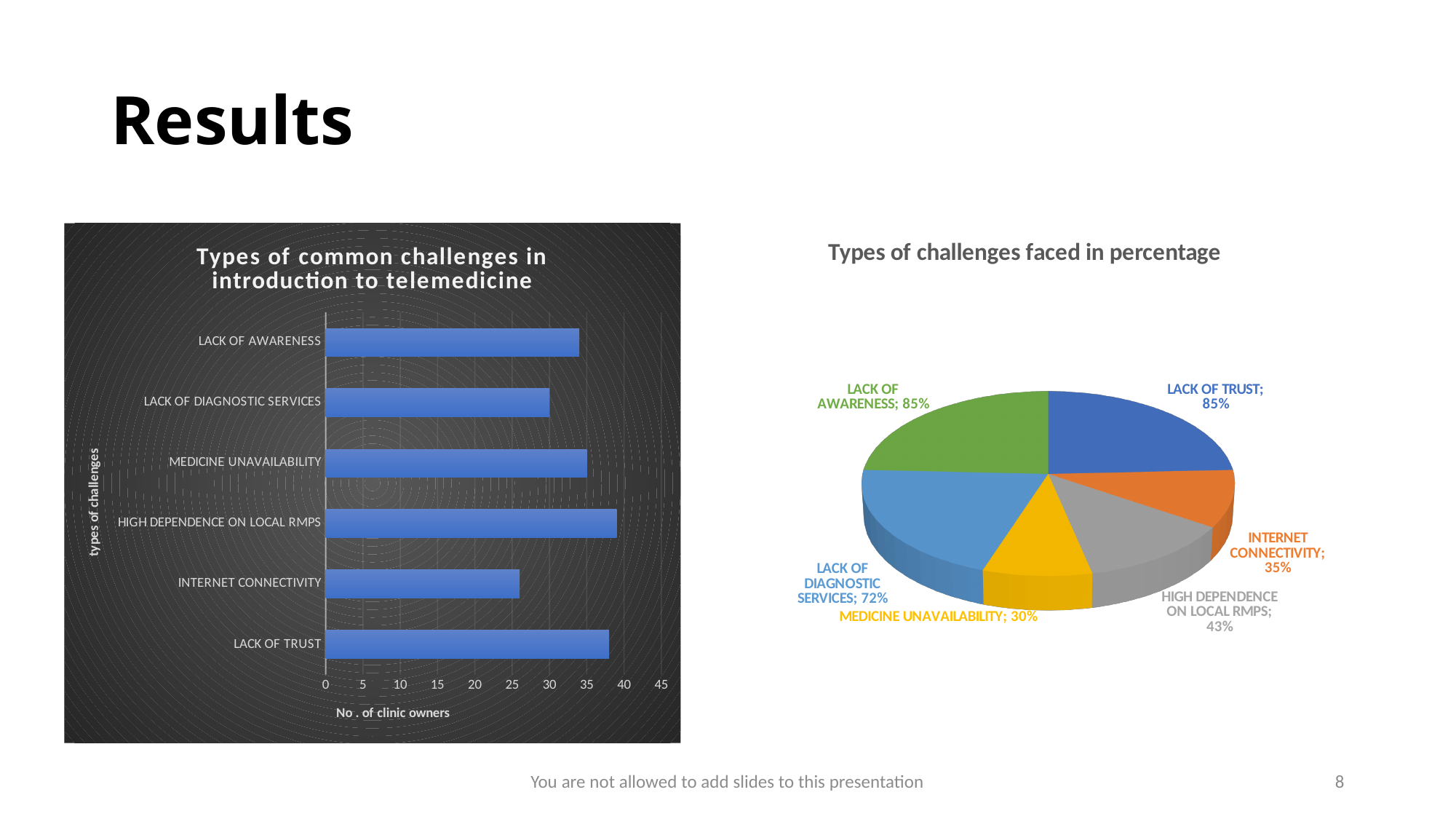
In the bar chart 'Types of common challenges in introduction to telemedicine', which category has the lowest value? INTERNET CONNECTIVITY In the bar chart 'Types of common challenges in introduction to telemedicine', how many categories are shown? 6 In the bar chart 'Types of common challenges in introduction to telemedicine', what is the label of the horizontal axis? No . of clinic owners In the pie chart 'Types of challenges faced in percentage', what is the value for INTERNET CONNECTIVITY? 35% In the bar chart 'Types of common challenges in introduction to telemedicine', is the value for INTERNET CONNECTIVITY greater or less than 30? less In the bar chart 'Types of common challenges in introduction to telemedicine', is the value for HIGH DEPENDENCE ON LOCAL RMPS greater or less than 35? greater What type of chart is the chart titled 'Types of common challenges in introduction to telemedicine'? bar chart In the bar chart 'Types of common challenges in introduction to telemedicine', which is larger: LACK OF AWARENESS or LACK OF DIAGNOSTIC SERVICES? LACK OF AWARENESS In the pie chart 'Types of challenges faced in percentage', which category has the smallest value? MEDICINE UNAVAILABILITY What type of chart is the chart titled 'Types of challenges faced in percentage'? pie chart In the pie chart 'Types of challenges faced in percentage', what is the difference between LACK OF DIAGNOSTIC SERVICES and HIGH DEPENDENCE ON LOCAL RMPS? 29% In the pie chart 'Types of challenges faced in percentage', what is the value for LACK OF DIAGNOSTIC SERVICES? 72%